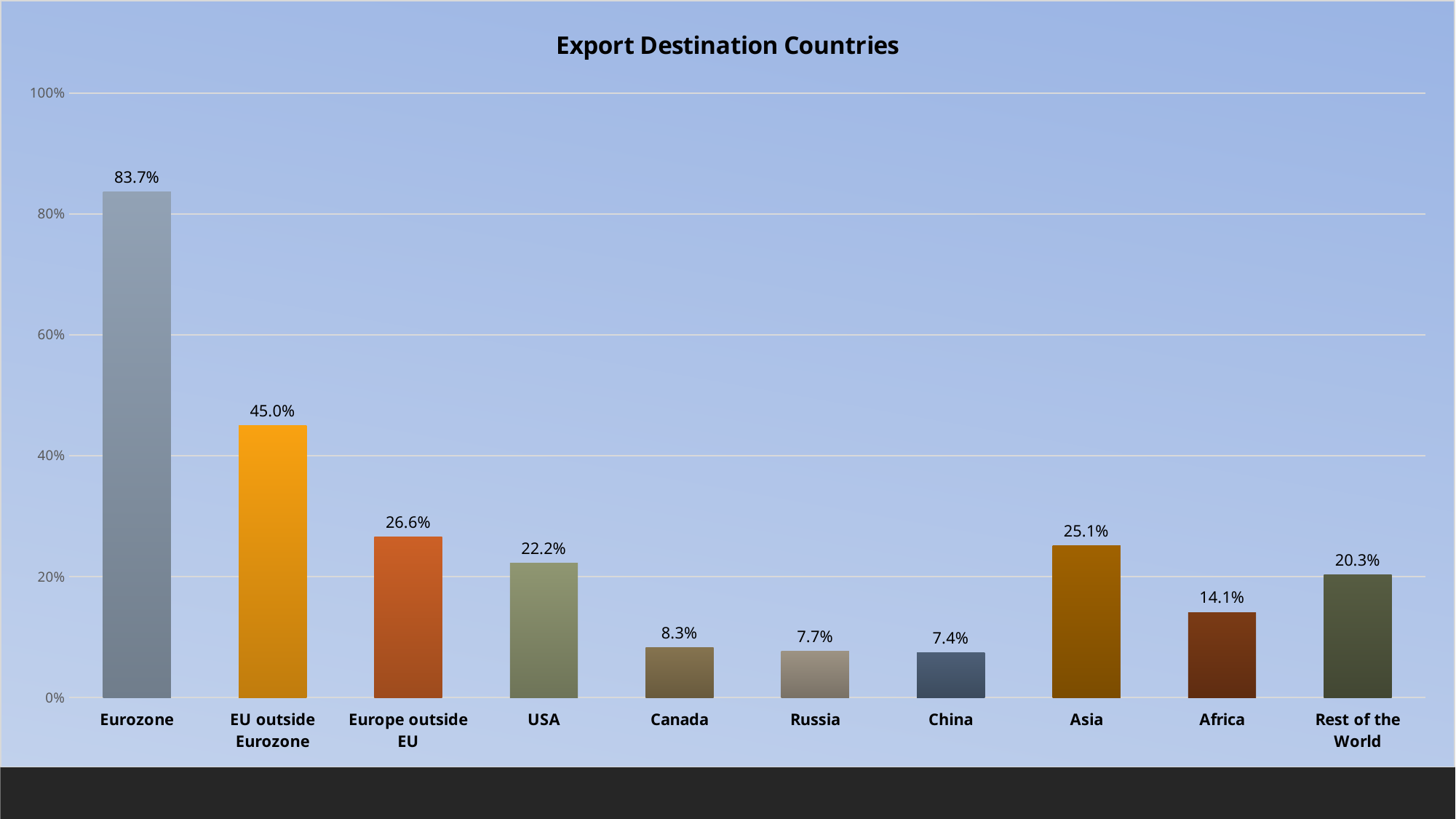
What is the difference between the values for EU outside Eurozone and USA? 22.8% What is the difference between the values for Canada and Russia? 0.6% How many categories are shown on the x axis? 10 What is the title of the chart? Export Destination Countries Which category has the lowest value? China Which category has the highest value? Eurozone What is the value for Asia? 25.1% Which is larger, the value for Europe outside EU or the value for Asia? Europe outside EU What is the value for Rest of the World? 20.3% What is the value for Eurozone? 83.7% What kind of chart is shown on the slide? bar chart Is the value for Africa greater or less than 20%? less